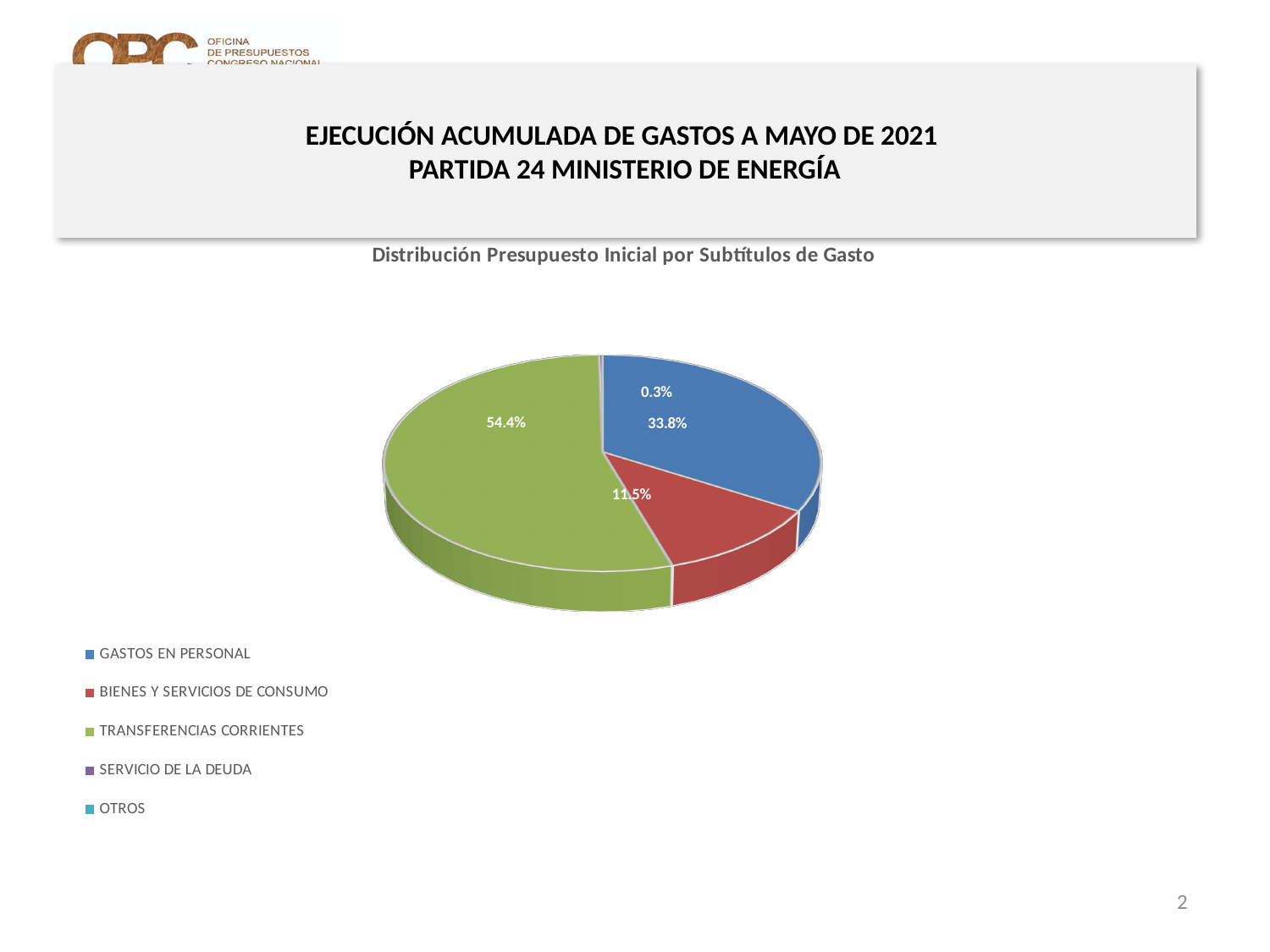
Which is larger, the slice for GASTOS EN PERSONAL or the slice for BIENES Y SERVICIOS DE CONSUMO? GASTOS EN PERSONAL What share of the pie does GASTOS EN PERSONAL represent? 33.8% What share of the pie does TRANSFERENCIAS CORRIENTES represent? 54.4% By how many percentage points does GASTOS EN PERSONAL exceed BIENES Y SERVICIOS DE CONSUMO? 22.3 percentage points What is the title of the pie chart? Distribución Presupuesto Inicial por Subtítulos de Gasto Which category has the largest slice of the pie? TRANSFERENCIAS CORRIENTES What share of the pie does BIENES Y SERVICIOS DE CONSUMO represent? 11.5% How many categories does the legend of the pie chart list? 5 Is the share for TRANSFERENCIAS CORRIENTES greater or less than 50%? greater What kind of chart is shown on the slide? Pie chart By how many percentage points does TRANSFERENCIAS CORRIENTES exceed GASTOS EN PERSONAL? 20.6 percentage points What is the smallest percentage labelled on the pie chart? 0.3%